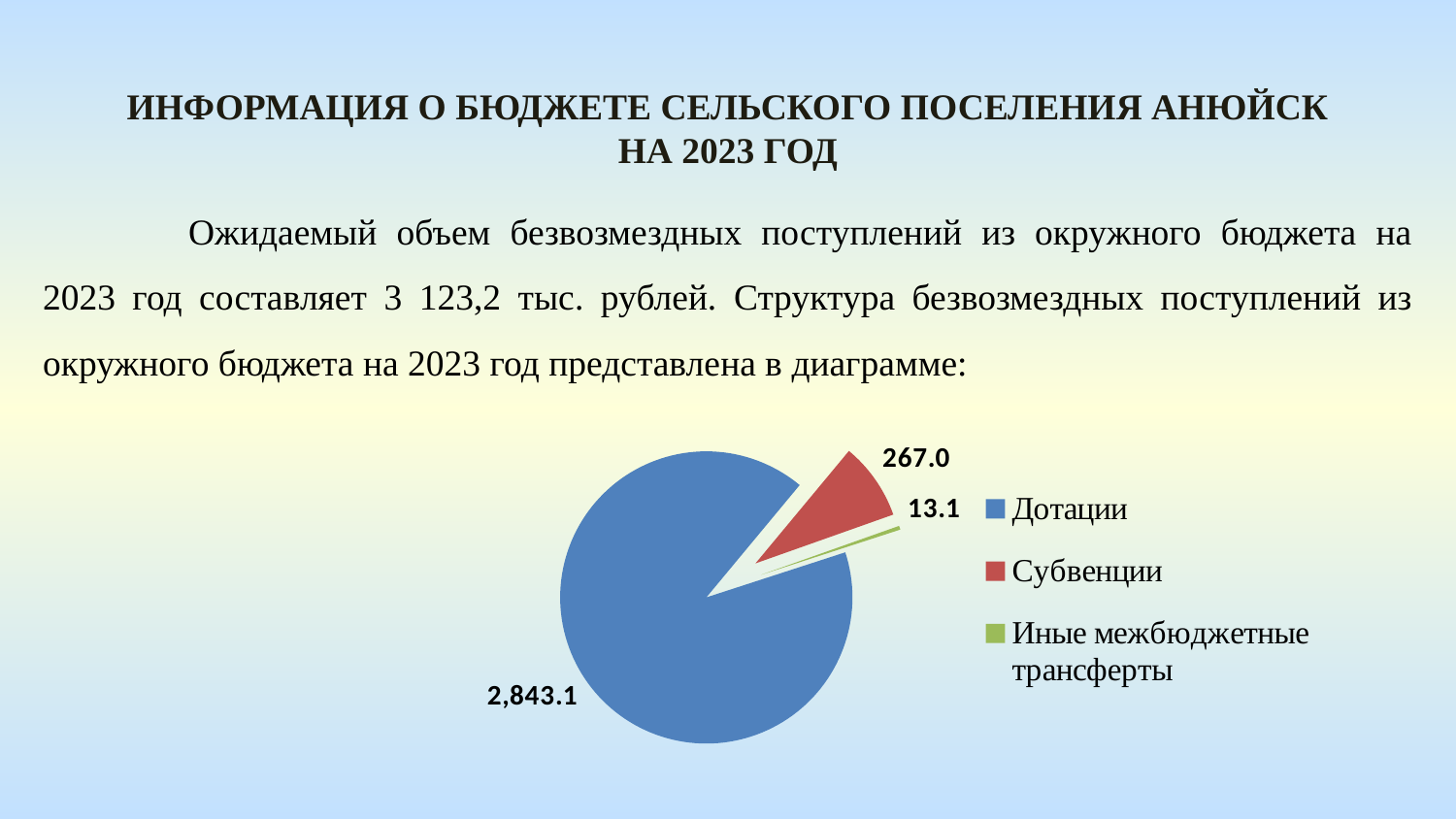
What is the difference between the values for Субвенции and Иные межбюджетные трансферты? 253.9 What is the value for Субвенции in the pie chart? 267.0 What kind of chart is shown on the slide? Pie chart Which category has the largest slice in the pie chart? Дотации What is the value for Дотации in the pie chart? 2,843.1 How many categories are shown in the pie chart? 3 What is the difference between the values for Дотации and Субвенции? 2,576.1 What is the value for Иные межбюджетные трансферты in the pie chart? 13.1 Which category has the smallest slice in the pie chart? Иные межбюджетные трансферты What is the total of all slices in the pie chart? 3,123.2 What colour is the slice for Субвенции in the pie chart? Red Which is larger, the value for Субвенции or the value for Иные межбюджетные трансферты? Субвенции